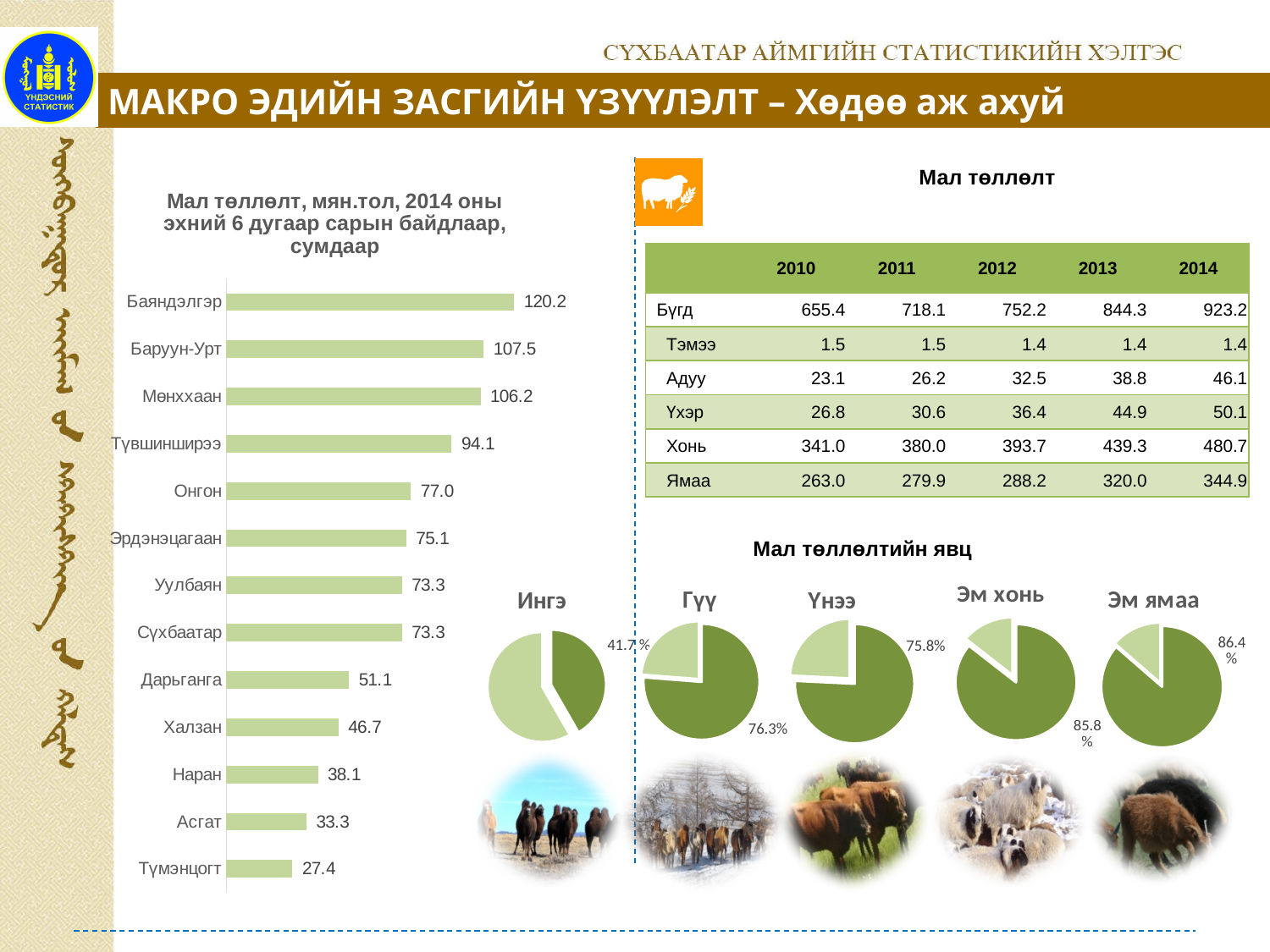
In the bar chart on the left, what is the value for Онгон? 77.0 In the bar chart on the left, which category has the highest value? Баяндэлгэр What type of chart is the chart on the left titled 'Мал төллөлт, мян.тол, 2014 оны эхний 6 дугаар сарын байдлаар, сумдаар'? Bar chart In the bar chart on the left, what is the difference between the values for Баруун-Урт and Мөнххаан? 1.3 How many categories are shown in the bar chart on the left? 13 In the pie chart titled 'Ингэ', what percentage is labelled? 41.7% In the bar chart on the left, which category has the lowest value? Түмэнцогт In the pie chart titled 'Эм ямаа', what percentage is labelled? 86.4% Which labelled percentage is larger, the one in the 'Гүү' pie chart or the one in the 'Үнээ' pie chart? Гүү (76.3%) In the bar chart on the left, which is larger, the value for Дарьганга or the value for Халзан? Дарьганга In the bar chart on the left, what is the value for Баяндэлгэр? 120.2 How many pie charts are shown under the heading 'Мал төллөлтийн явц'? 5